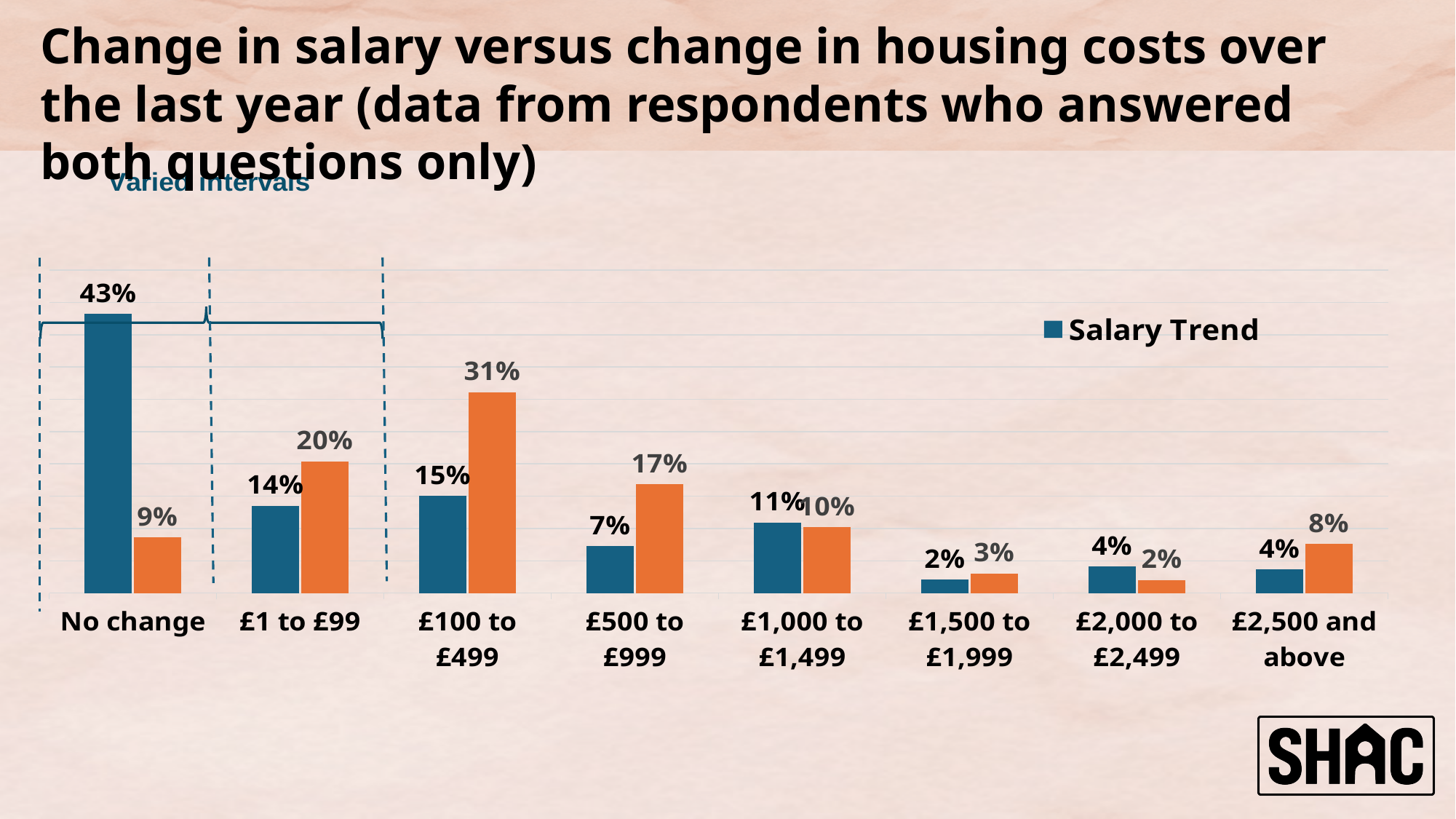
What series name is listed in the chart legend? Salary Trend What is the Salary Trend value for the 'No change' category? 43% What is the difference between the Salary Trend value and the orange bar value for 'No change'? 34% How many categories are shown on the x axis? 8 What type of chart is shown on the slide? Bar chart Which category has the highest Salary Trend value? No change What is the value of the orange bar for '£2,500 and above'? 8% What is the Salary Trend value for '£500 to £999'? 7% What is the value of the orange bar for the '£100 to £499' category? 31% Which category has the lowest Salary Trend value? £1,500 to £1,999 Which category has the highest value among the orange bars? £100 to £499 For '£1 to £99', which is larger: the Salary Trend bar or the orange bar? The orange bar